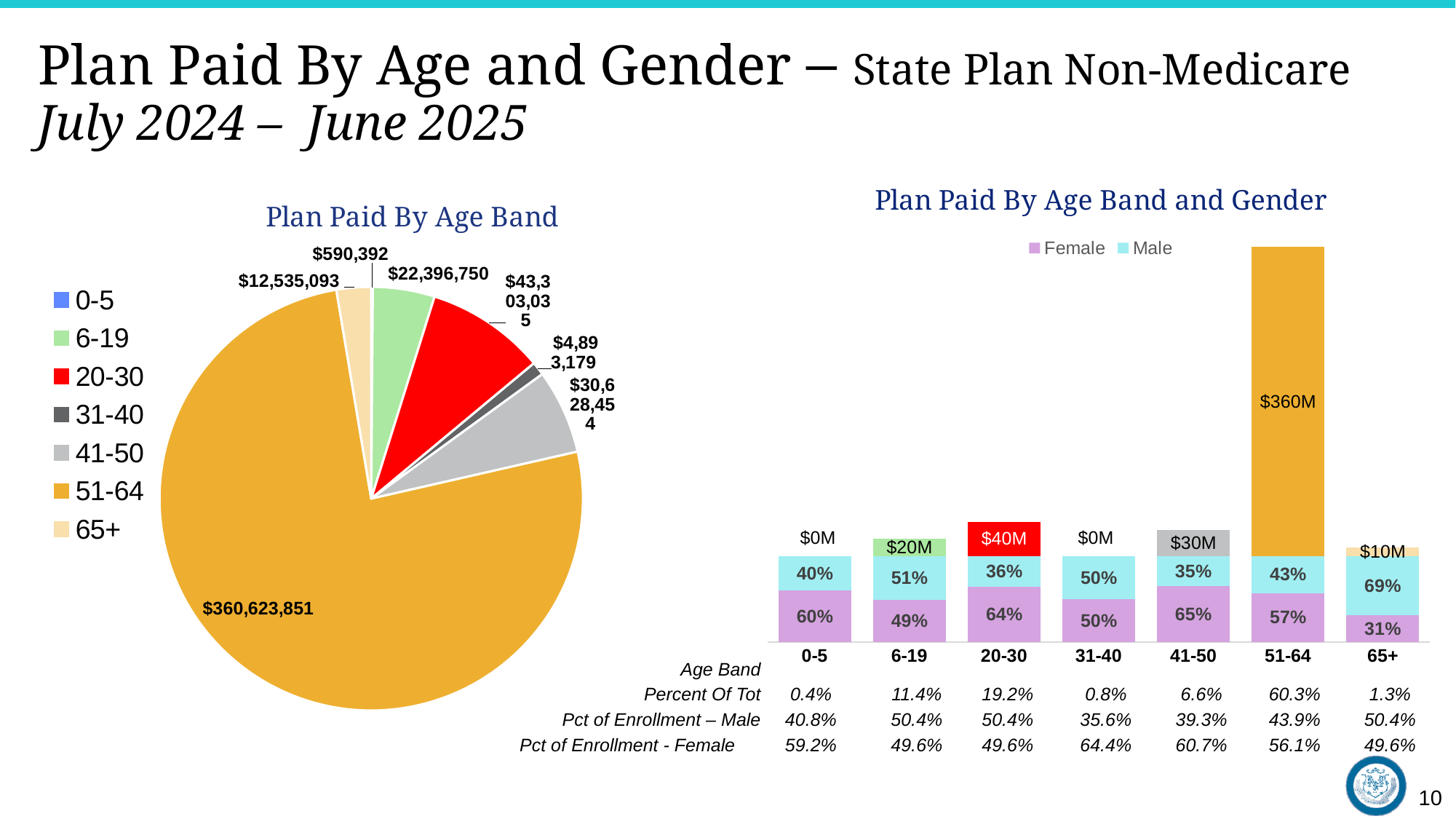
In the 'Plan Paid By Age Band' pie chart, what is the plan paid amount for the 65+ age band? $12,535,093 In the 'Plan Paid By Age Band' pie chart, what is the plan paid amount for the 51-64 age band? $360,623,851 In the 'Plan Paid By Age Band and Gender' chart, what percentage is shown for Male in the 65+ age band? 69% In the 'Plan Paid By Age Band' pie chart, how many age bands are shown in the legend? 7 What kind of chart is 'Plan Paid By Age Band and Gender'? Bar chart In the 'Plan Paid By Age Band and Gender' chart, what percentage is shown for Female in the 20-30 age band? 64% In the 'Plan Paid By Age Band' pie chart, what is the plan paid amount for the 6-19 age band? $22,396,750 In the 'Plan Paid By Age Band and Gender' chart, which is larger: the Female percentage for 41-50 or the Female percentage for 65+? 41-50 In the 'Plan Paid By Age Band' pie chart, what is the difference between the plan paid amounts for the 51-64 and 20-30 age bands? $317,320,816 In the 'Plan Paid By Age Band and Gender' chart, how many series does the legend list? 2 In the 'Plan Paid By Age Band' pie chart, which age band has the smallest plan paid amount? 0-5 In the 'Plan Paid By Age Band' pie chart, which age band has the largest plan paid amount? 51-64